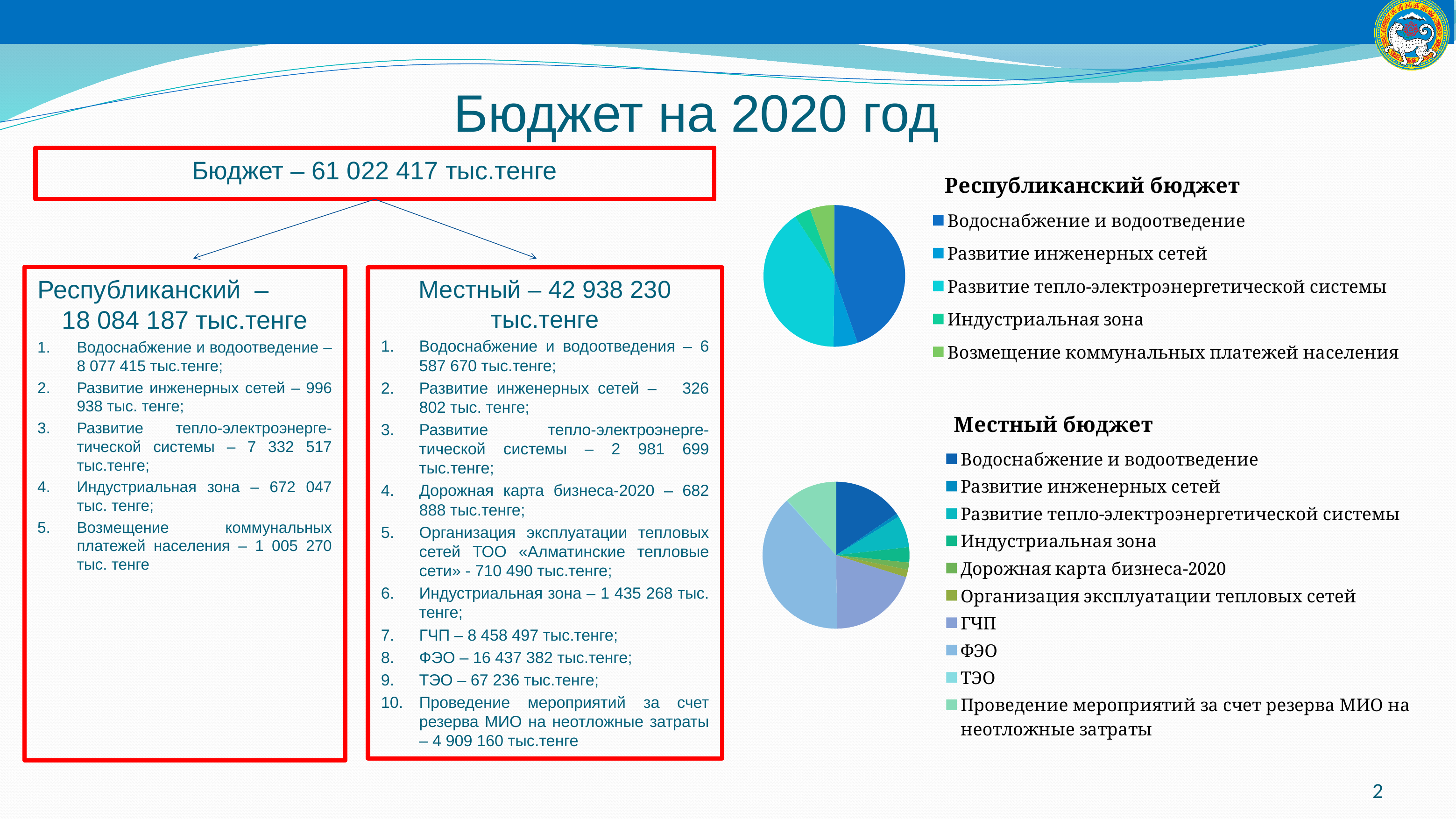
What is the title of the upper pie chart on the slide? Республиканский бюджет In the 'Местный бюджет' pie chart, which category has the largest slice? ФЭО What kind of chart is the 'Республиканский бюджет' chart? pie chart How many categories does the legend of the 'Местный бюджет' pie chart list? 10 In the 'Республиканский бюджет' chart, what is the value for Индустриальная зона according to the slide? 672 047 тыс. тенге In the 'Республиканский бюджет' pie chart, which category has the smallest slice? Индустриальная зона In the 'Республиканский бюджет' pie chart, which category has the largest slice? Водоснабжение и водоотведение In the 'Местный бюджет' pie chart, which slice is larger: ГЧП or Водоснабжение и водоотведение? ГЧП How many categories does the legend of the 'Республиканский бюджет' pie chart list? 5 In the 'Местный бюджет' chart, what is the value for ФЭО according to the slide? 16 437 382 тыс.тенге What is the total of all slices in the 'Республиканский бюджет' pie chart, as stated on the slide? 18 084 187 тыс.тенге In the 'Местный бюджет' pie chart, which category has the smallest slice? ТЭО